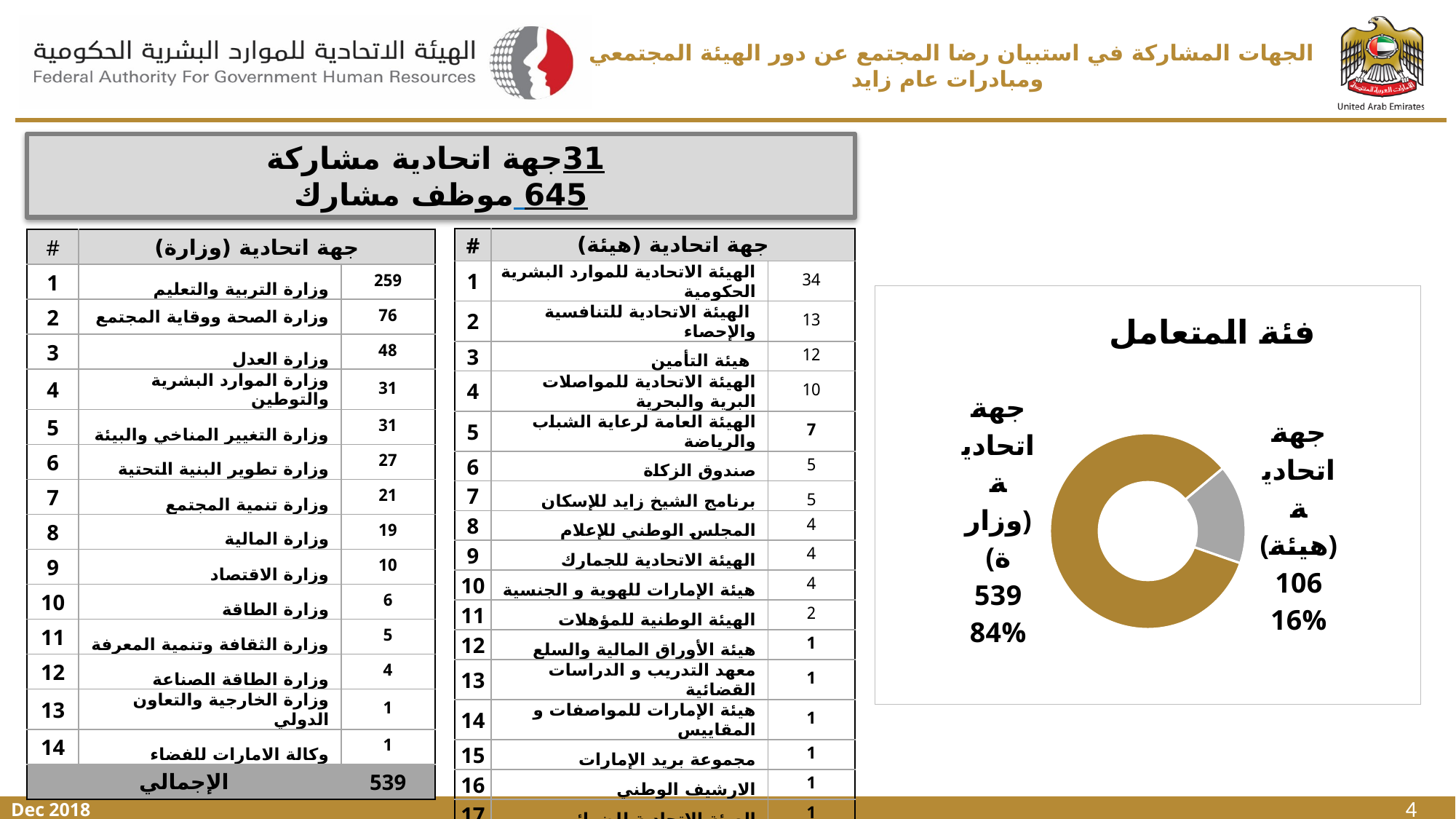
In the "فئة المتعامل" chart, which category has the largest slice? جهة اتحادية (وزارة) In the "فئة المتعامل" chart, what percentage share does "جهة اتحادية (وزارة)" have? 84% In the "فئة المتعامل" chart, what is the total of the two slice values? 645 In the "فئة المتعامل" chart, what percentage share does "جهة اتحادية (هيئة)" have? 16% What kind of chart is shown under the title "فئة المتعامل"? Doughnut (pie) chart In the "فئة المتعامل" chart, what value is shown for "جهة اتحادية (وزارة)"? 539 In the "فئة المتعامل" chart, which category has the smallest slice? جهة اتحادية (هيئة) In the "فئة المتعامل" chart, what is the difference between the values for "جهة اتحادية (وزارة)" and "جهة اتحادية (هيئة)"? 433 In the "فئة المتعامل" chart, what value is shown for "جهة اتحادية (هيئة)"? 106 In the "فئة المتعامل" chart, which is larger: the value for "جهة اتحادية (وزارة)" or for "جهة اتحادية (هيئة)"? جهة اتحادية (وزارة) In the "فئة المتعامل" chart, what colour is the slice for "جهة اتحادية (هيئة)"? Grey How many slices does the "فئة المتعامل" chart have? 2